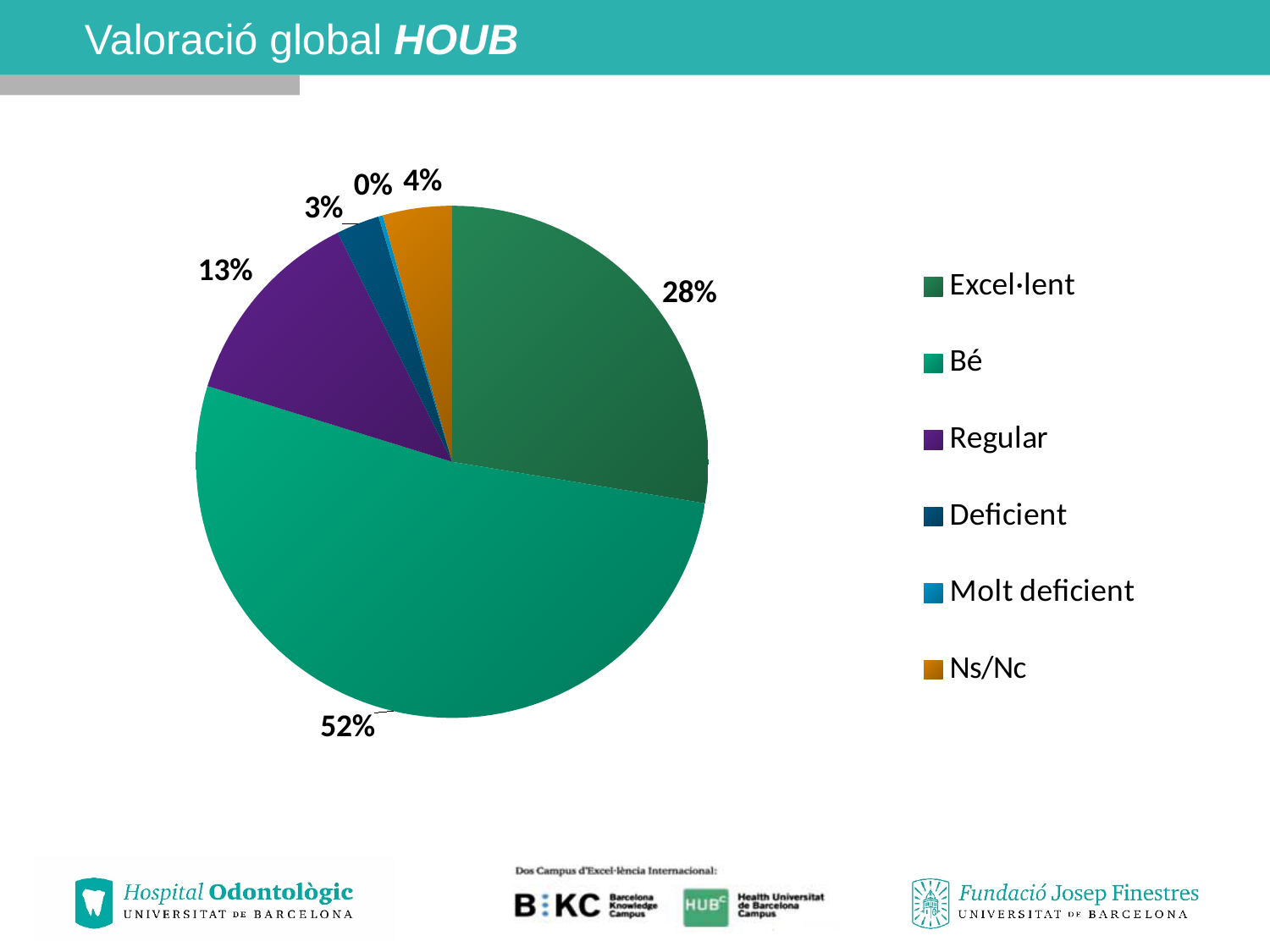
What share of the pie does Molt deficient represent? 0% What share of the pie does Bé represent? 52% Which is larger, the share for Regular or the share for Ns/Nc? Regular What is the difference in percentage points between Bé and Excel·lent? 24 What kind of chart is shown on the slide? pie chart What share of the pie does Deficient represent? 3% What share of the pie does Ns/Nc represent? 4% How many categories does the legend list? 6 What share of the pie does Regular represent? 13% Which category has the smallest slice of the pie? Molt deficient What share of the pie does Excel·lent represent? 28% Which category has the largest slice of the pie? Bé